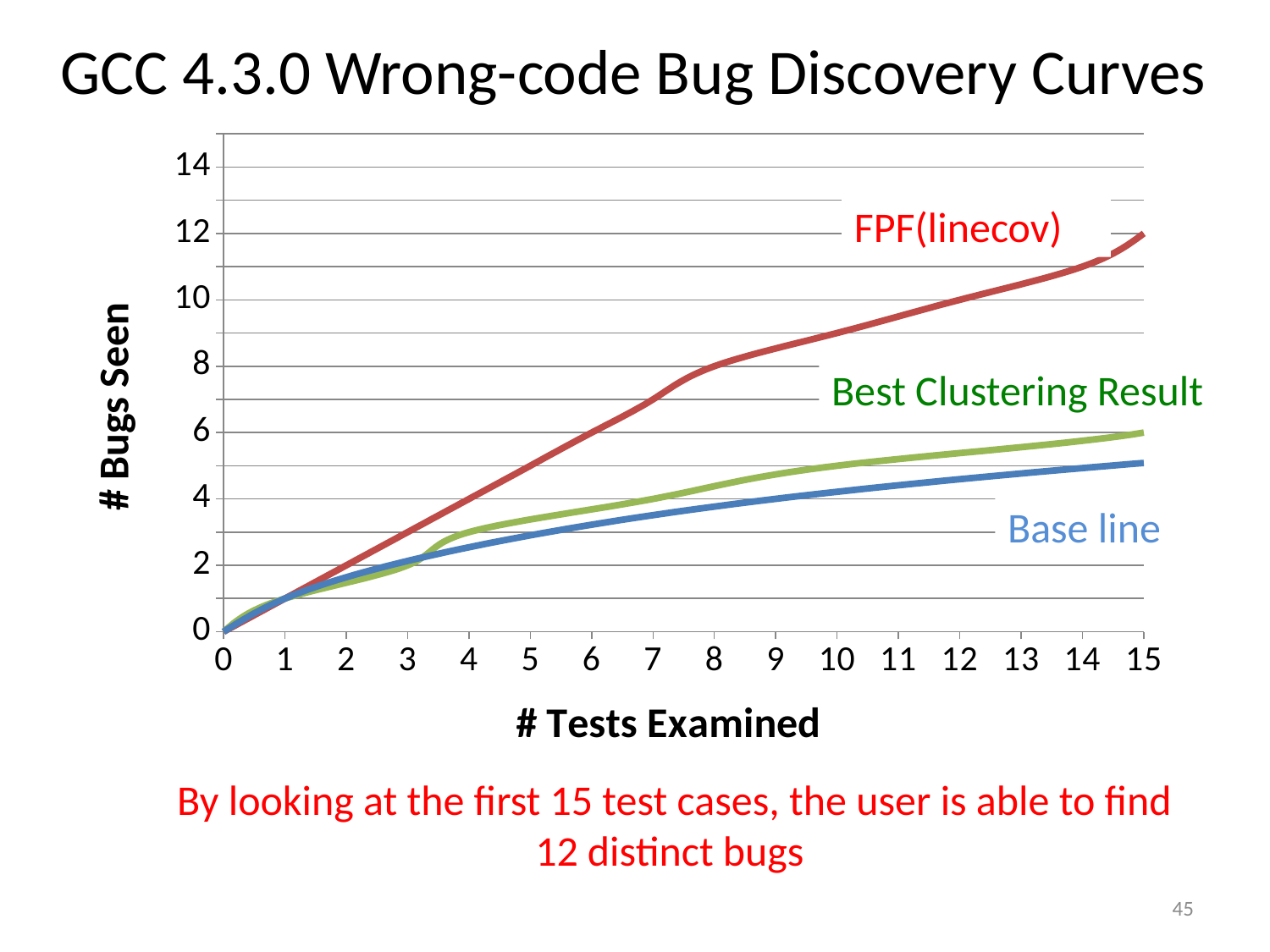
Is the value for FPF(linecov) at 8 tests examined greater or less than 6? greater What is the label of the x axis? # Tests Examined How many bugs has FPF(linecov) seen after 15 tests examined? 12 Do the curves rise or fall as the number of tests examined increases? rise At 8 tests examined, which is larger: FPF(linecov) or Base line? FPF(linecov) Which series has the highest value at 15 tests examined? FPF(linecov) How many series (lines) are plotted on the chart? 3 What is the difference between FPF(linecov) and Best Clustering Result at 15 tests examined? 6 Is the value for Base line at 10 tests examined greater or less than 6? less Which series has the lowest value at 15 tests examined? Base line What kind of chart is shown on the slide? line chart How many bugs has Best Clustering Result seen after 15 tests examined? 6